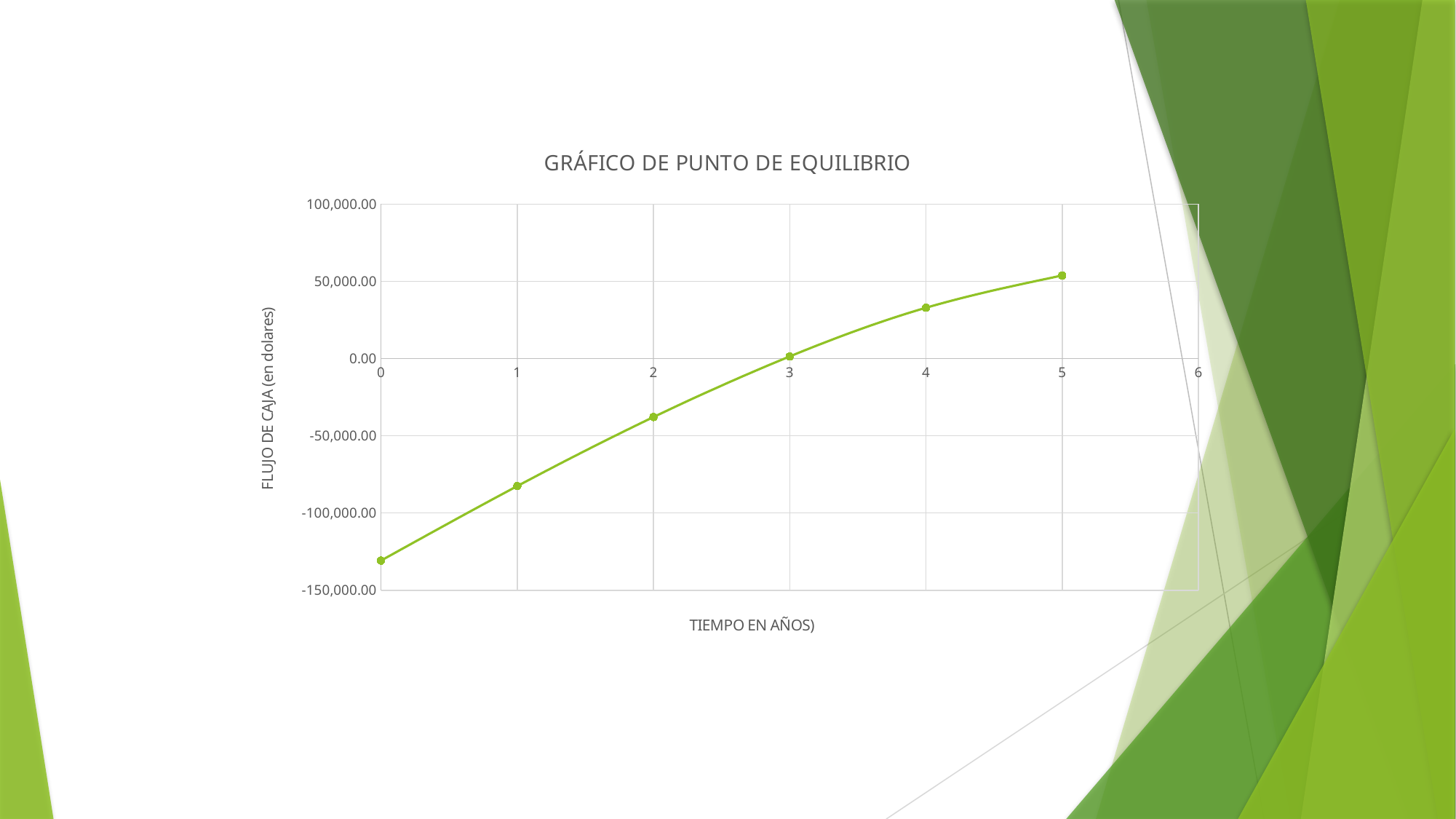
Is the value at year 1 greater or less than -100,000.00? greater Is the value at year 4 greater or less than 50,000.00? less What is the title of the chart? GRÁFICO DE PUNTO DE EQUILIBRIO What kind of chart is shown on the slide? line chart How many data points are plotted on the line? 6 Do the values rise or fall as time in years increases? rise What is the label of the vertical axis? FLUJO DE CAJA (en dolares) At which year is the cash flow value lowest? 0 Is the value at year 0 greater or less than -100,000.00? less At which year is the cash flow value highest? 5 Which has the larger cash flow value, year 2 or year 4? year 4